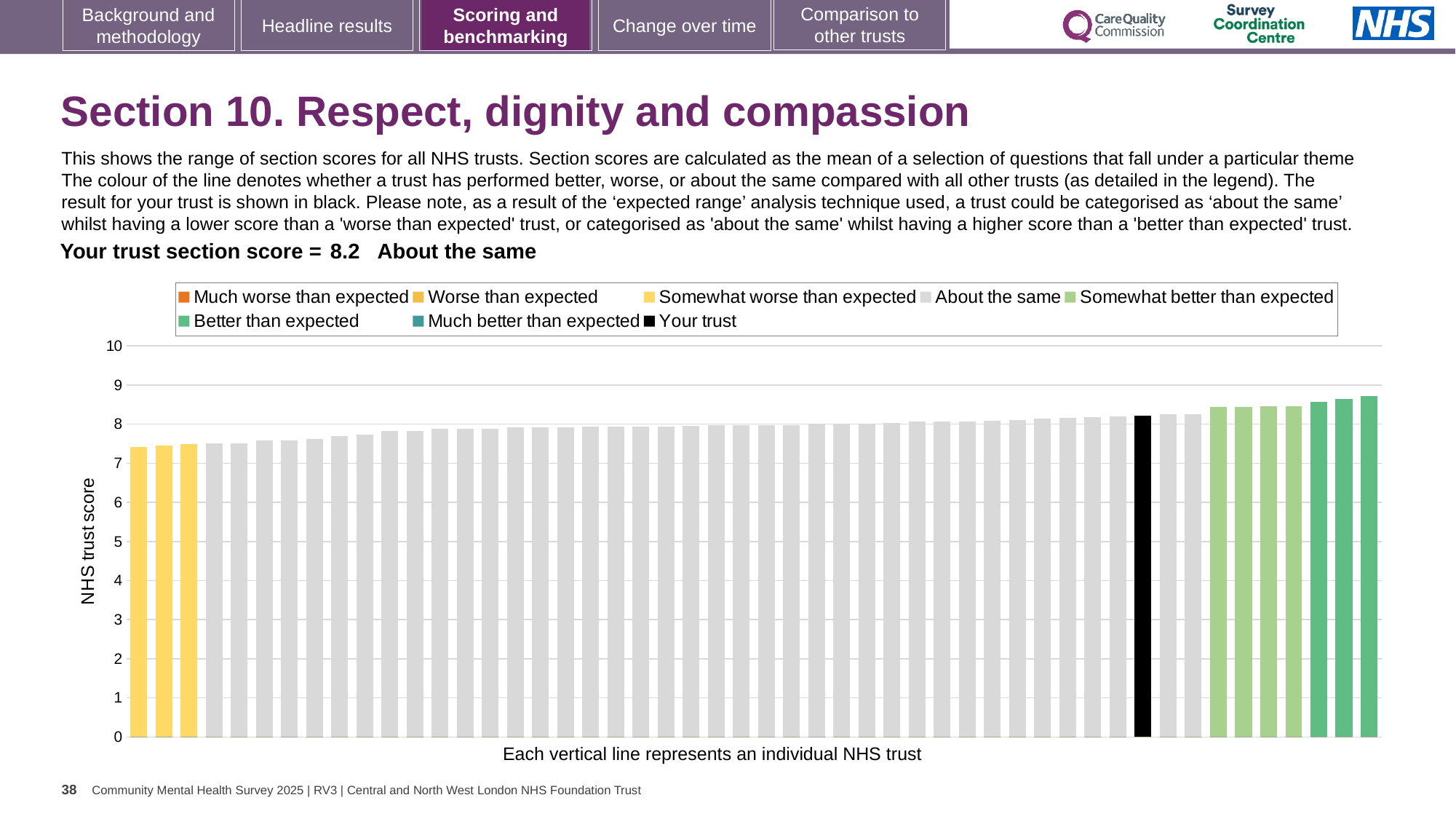
Is the value for your trust (the black bar) greater or less than 8? greater Is the value of the lowest bar in the chart greater or less than 8? less Is the value of the lowest bar in the chart greater or less than 7? greater Do the bar values rise or fall from left to right along the x axis? rise What is the title of the vertical axis? NHS trust score What is the section score for your trust shown on the slide? 8.2 How many entries does the chart legend list? 8 How many bars are coloured yellow (Somewhat worse than expected)? 3 Which is larger: the value for your trust (black bar) or the value of the leftmost bar? your trust What kind of chart is shown on the slide? bar chart Which category is your trust placed in according to the text above the chart? About the same